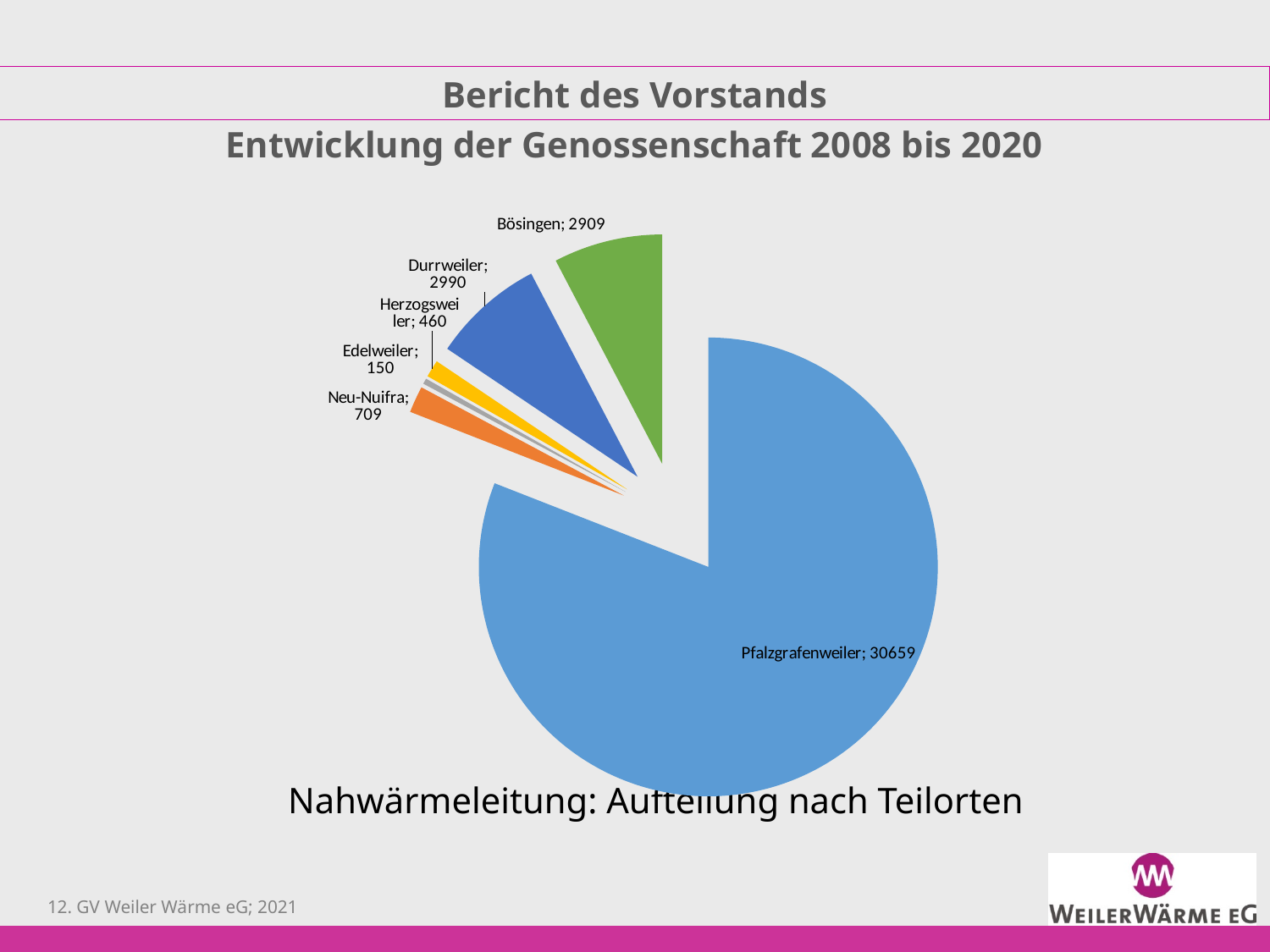
What is the value for Herzogsweiler? 460 Which Teilort has the smallest slice of the pie? Edelweiler How many slices does the pie chart have? 6 What kind of chart is shown on the slide? Pie chart What is the value for Pfalzgrafenweiler? 30659 What is the difference between the values for Neu-Nuifra and Herzogsweiler? 249 What is the title shown below the pie chart? Nahwärmeleitung: Aufteilung nach Teilorten What is the value for Durrweiler? 2990 What is the value for Neu-Nuifra? 709 Which Teilort has the largest slice of the pie? Pfalzgrafenweiler Which is larger, the value for Bösingen or the value for Durrweiler? Durrweiler What is the difference between the values for Durrweiler and Bösingen? 81